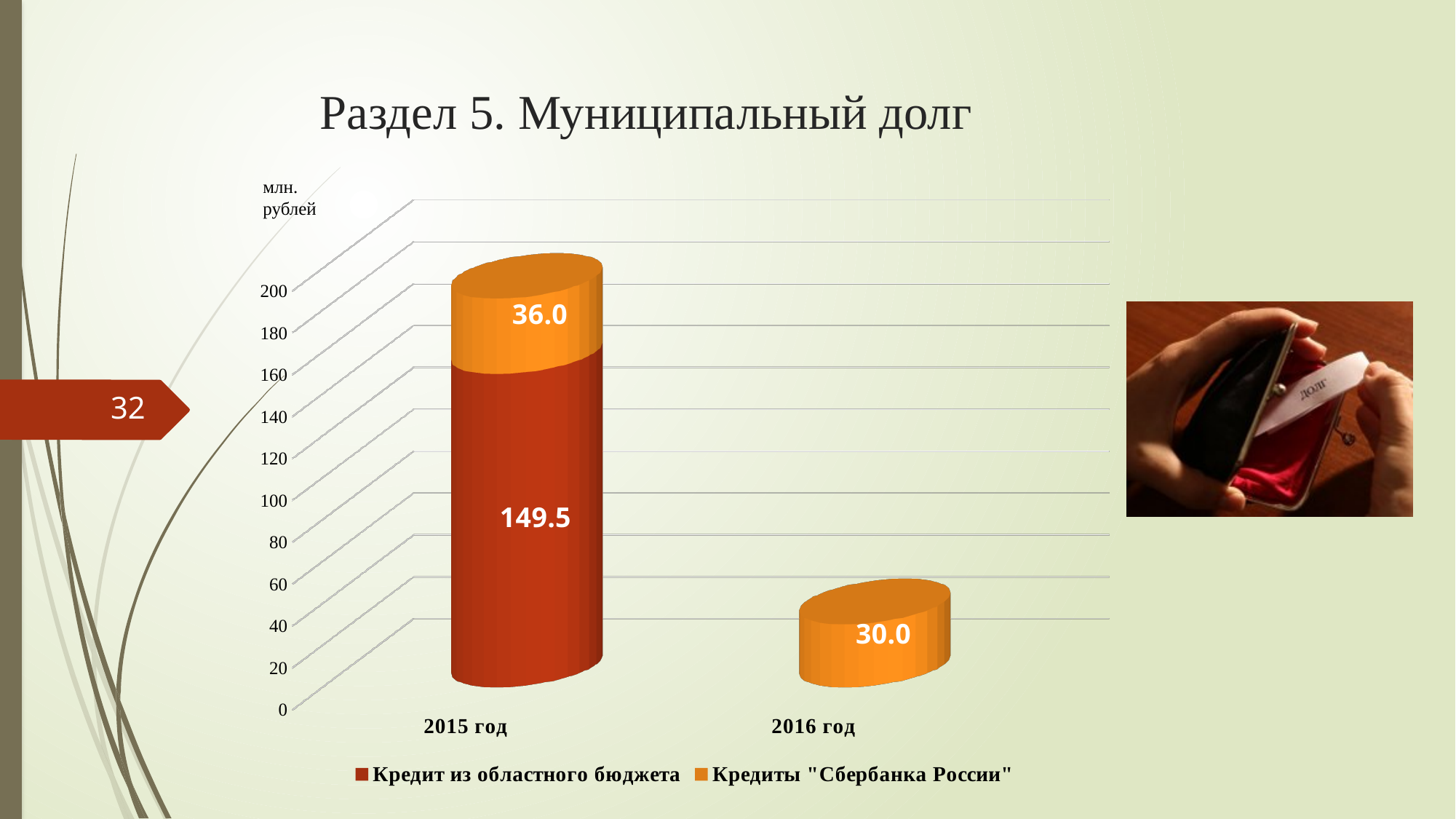
Does the total debt rise or fall from 2015 год to 2016 год? fall What kind of chart is shown on the slide? stacked bar chart How many series does the legend list? 2 What unit is shown on the vertical axis of the chart? млн. рублей What is the difference between the "Кредиты "Сбербанка России"" values for 2015 год and 2016 год? 6.0 What is the total of the stacked bar for 2015 год? 185.5 How many categories are shown on the x axis? 2 What is the value for "Кредиты "Сбербанка России"" in 2015 год? 36.0 What is the value for "Кредит из областного бюджета" in 2015 год? 149.5 Which year has the higher total municipal debt, 2015 год or 2016 год? 2015 год Which series has the larger value in 2015 год? Кредит из областного бюджета What is the value for "Кредиты "Сбербанка России"" in 2016 год? 30.0